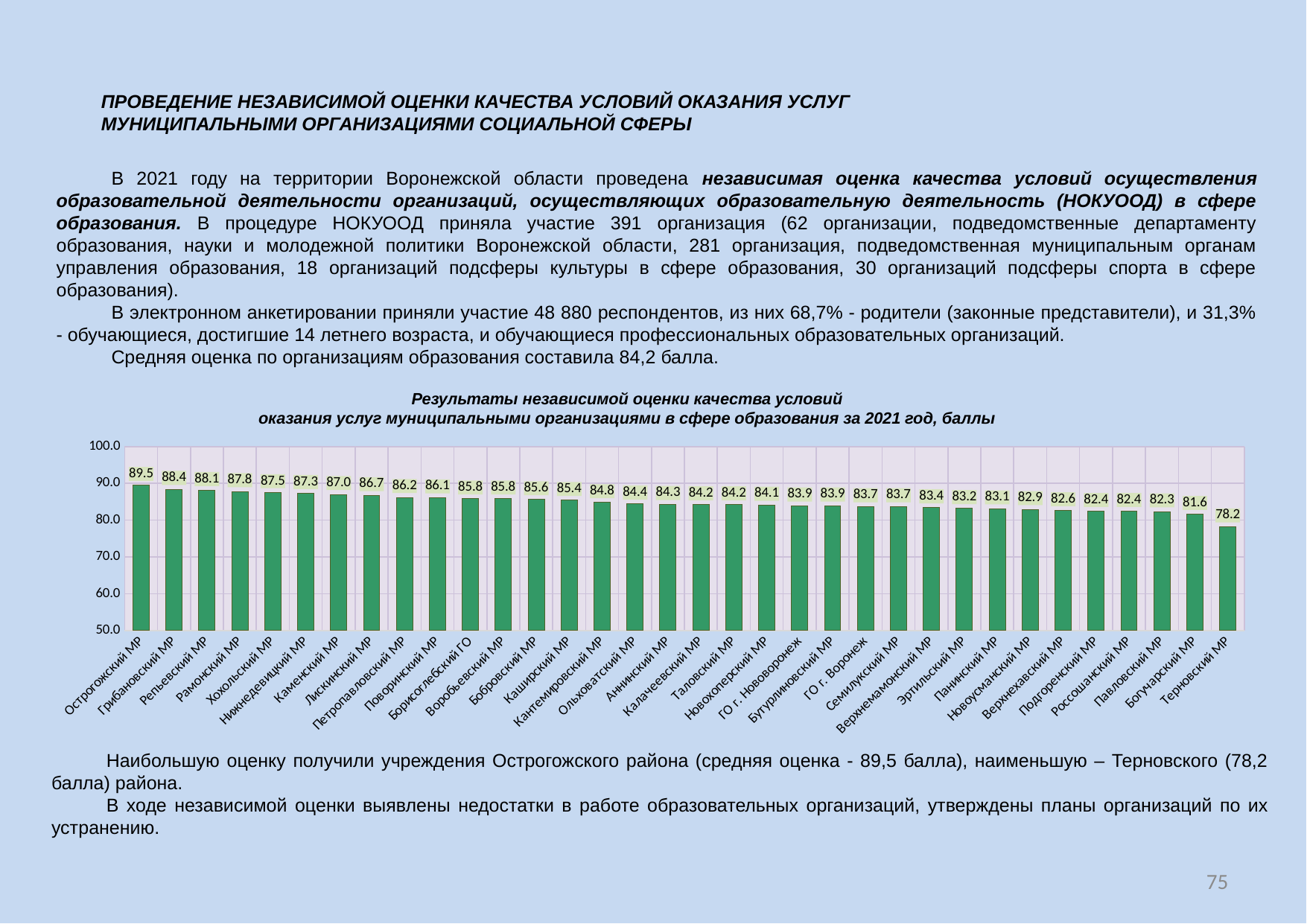
How many categories are plotted in the chart? 34 Is the value for Терновский МР greater or less than 80.0? less What is the value for ГО г. Воронеж? 83.7 What is the value for Терновский МР? 78.2 Which category has the highest value? Острогожский МР What type of chart is shown on the slide? bar chart Do the values rise or fall from left to right along the x axis? fall What is the value for Острогожский МР? 89.5 Which category has the lowest value? Терновский МР Which has a larger value, Лискинский МР or Богучарский МР? Лискинский МР What is the value for Каширский МР? 85.4 What is the difference between the values for Острогожский МР and Терновский МР? 11.3